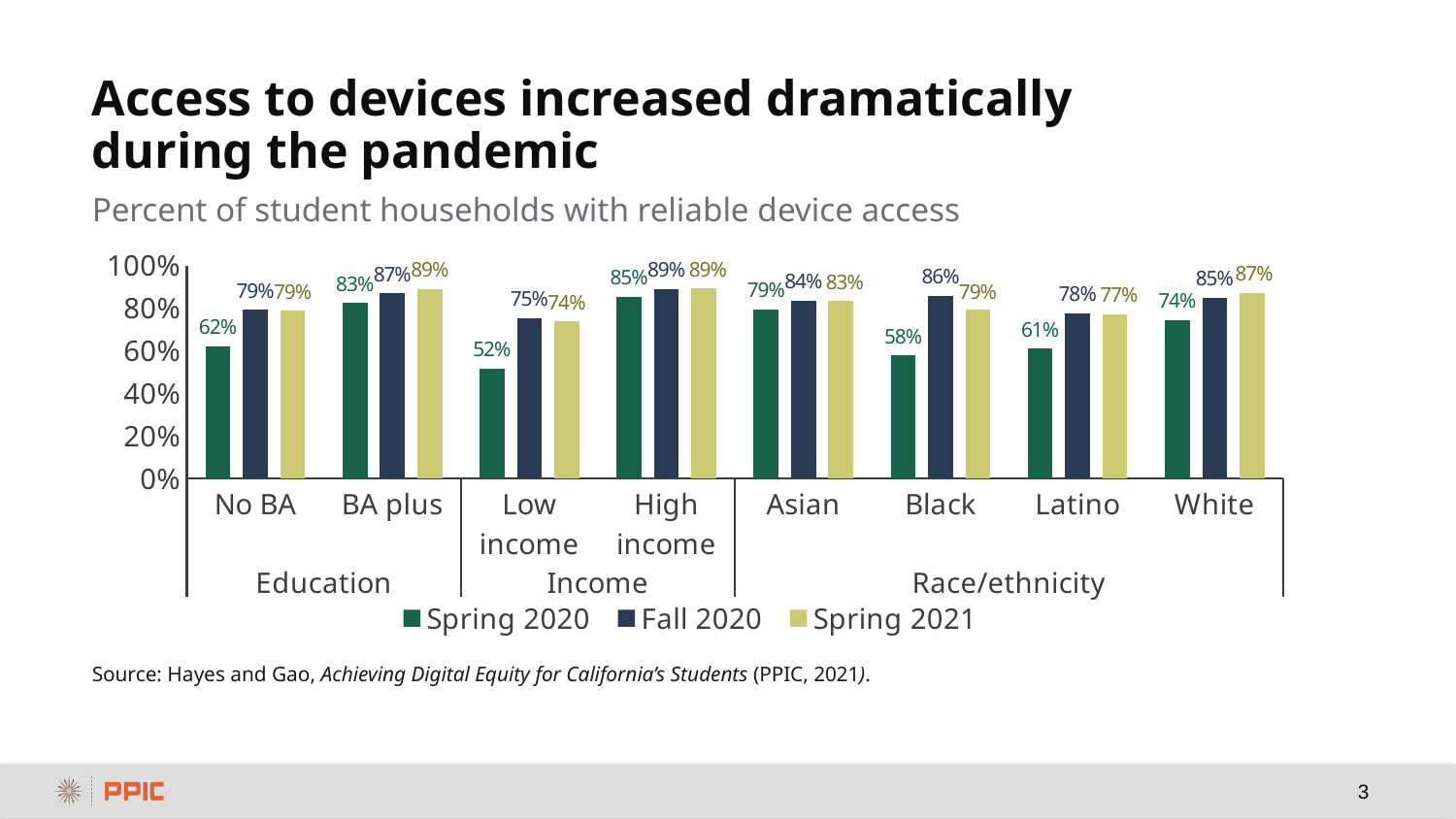
Which category has the lowest Spring 2020 value? Low income Which category has the highest Spring 2020 value? High income How many series does the legend list? 3 What is the Fall 2020 value for Black? 86% What is the Spring 2021 value for White? 87% Which is larger, the Spring 2020 value for Asian or the Spring 2020 value for Latino? Asian How many categories are shown on the x axis? 8 What are the three groups the categories are organised into along the x axis? Education, Income, Race/ethnicity What is the difference between the Spring 2021 values for BA plus and No BA? 10% What kind of chart is shown on the slide? Bar chart What is the difference between the Fall 2020 and Spring 2020 values for Black? 28% What is the Spring 2020 value for Low income? 52%